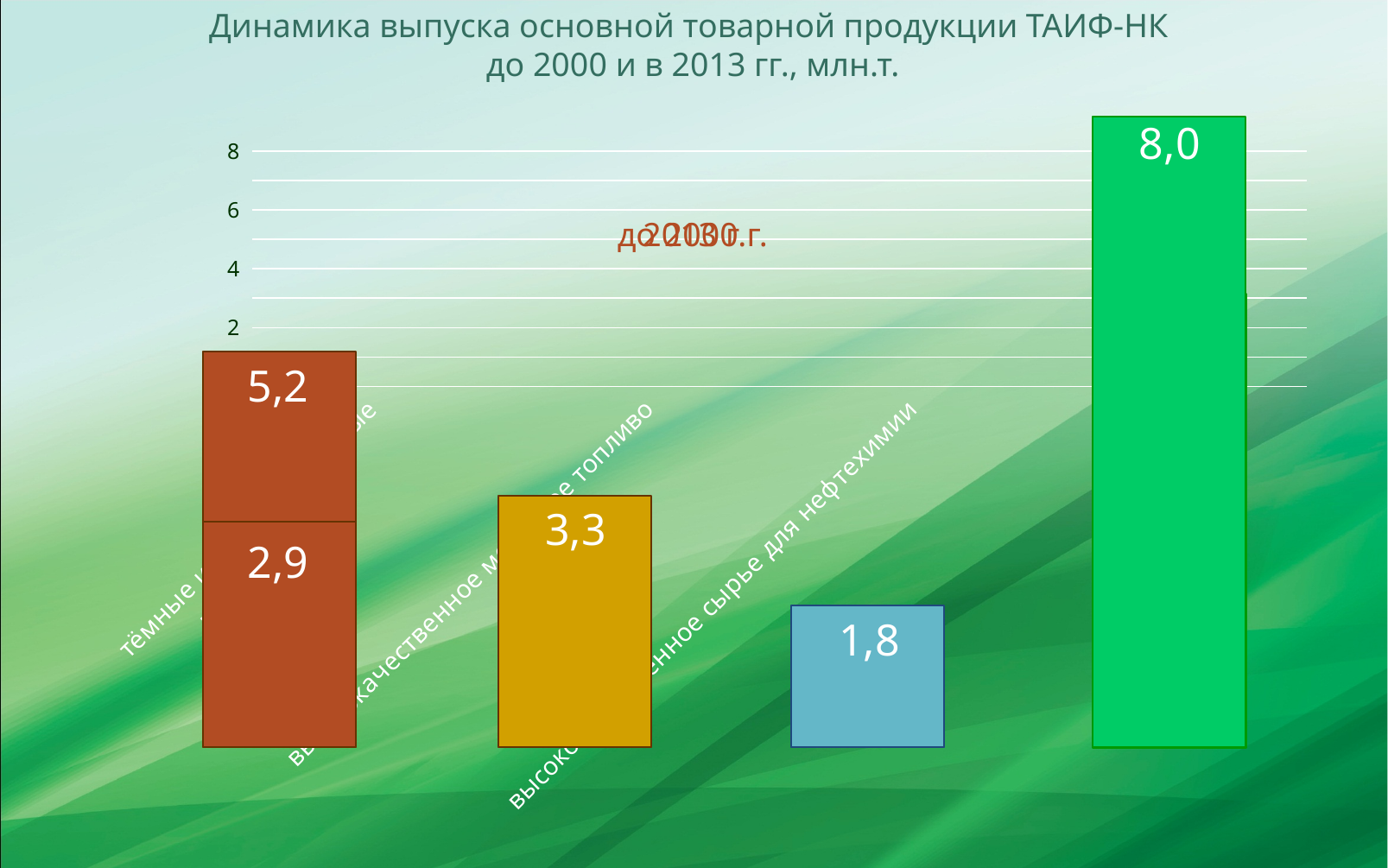
What is the difference between the green bar's value and the blue bar's value? 6,2 Which single bar has the lowest printed value? the blue bar (1,8) Which bar has the highest printed value? the green bar (8,0) What two values are printed on the stacked brown bar at the left of the chart? 5,2 and 2,9 What value is printed on the yellow bar? 3,3 What value is printed on the blue bar? 1,8 What value is printed on the green bar at the right of the chart? 8,0 What is the title of the chart? Динамика выпуска основной товарной продукции ТАИФ-НК до 2000 и в 2013 гг., млн.т. Which is larger, the yellow bar's value or the blue bar's value? the yellow bar (3,3) What kind of chart is shown on the slide? bar chart How many bars are plotted on the chart? 4 What is the total of the two segments of the stacked brown bar? 8,1